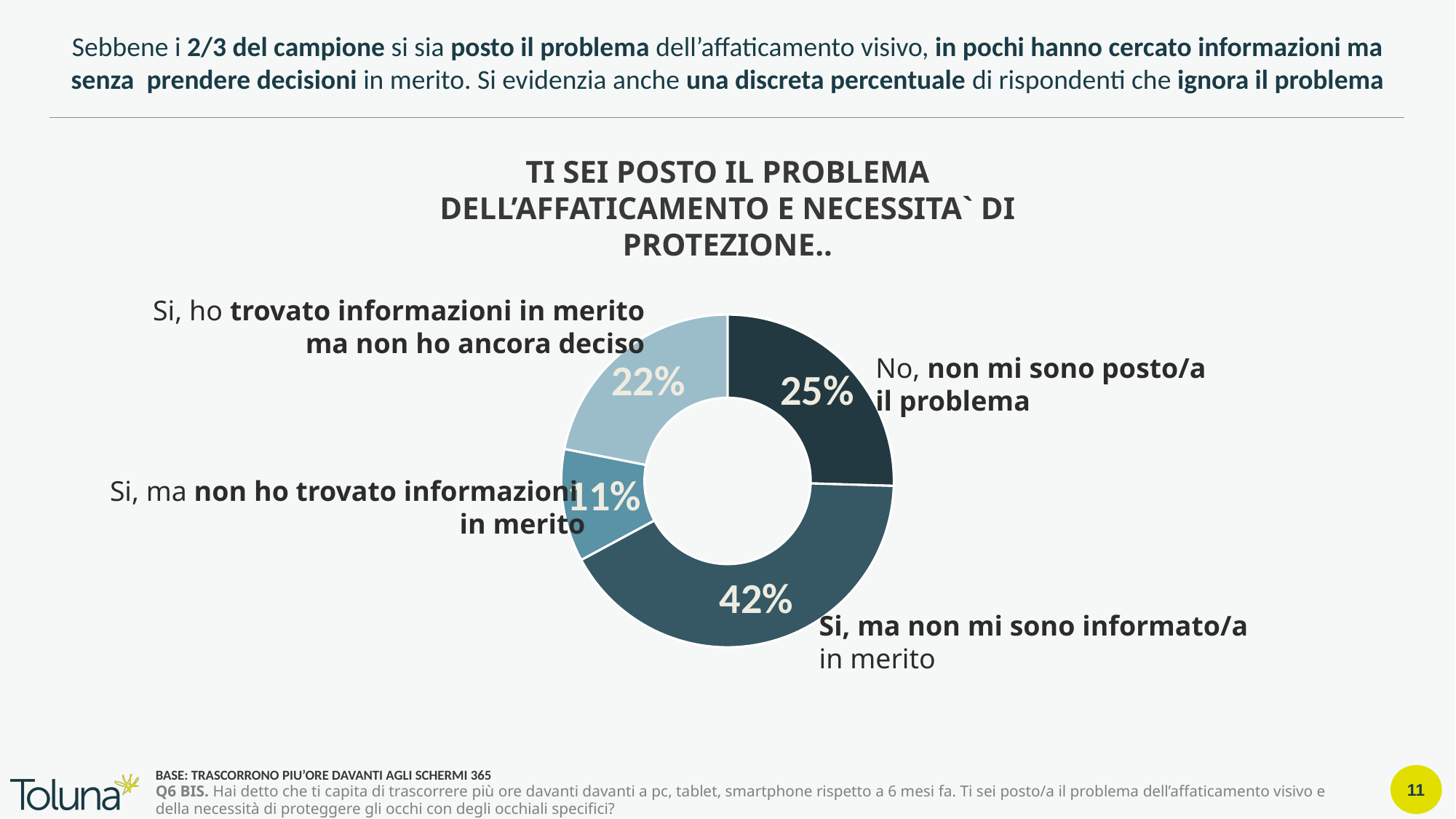
What kind of chart is shown on the slide? Doughnut (pie) chart Which is larger: the share for "Si, ho trovato informazioni in merito ma non ho ancora deciso" or the share for "No, non mi sono posto/a il problema"? No, non mi sono posto/a il problema What is the title of the chart? TI SEI POSTO IL PROBLEMA DELL'AFFATICAMENTO E NECESSITA` DI PROTEZIONE.. What is the combined share of the three "Si" responses? 75% Which response has the smallest share of the chart? Si, ma non ho trovato informazioni in merito What is the difference in percentage points between "Si, ma non mi sono informato/a in merito" and "No, non mi sono posto/a il problema"? 17 What percentage of respondents answered "Si, ma non mi sono informato/a in merito"? 42% Which response has the largest share of the chart? Si, ma non mi sono informato/a in merito What percentage of respondents answered "No, non mi sono posto/a il problema"? 25% What percentage of respondents answered "Si, ho trovato informazioni in merito ma non ho ancora deciso"? 22% How many response categories are shown in the chart? 4 What percentage of respondents answered "Si, ma non ho trovato informazioni in merito"? 11%